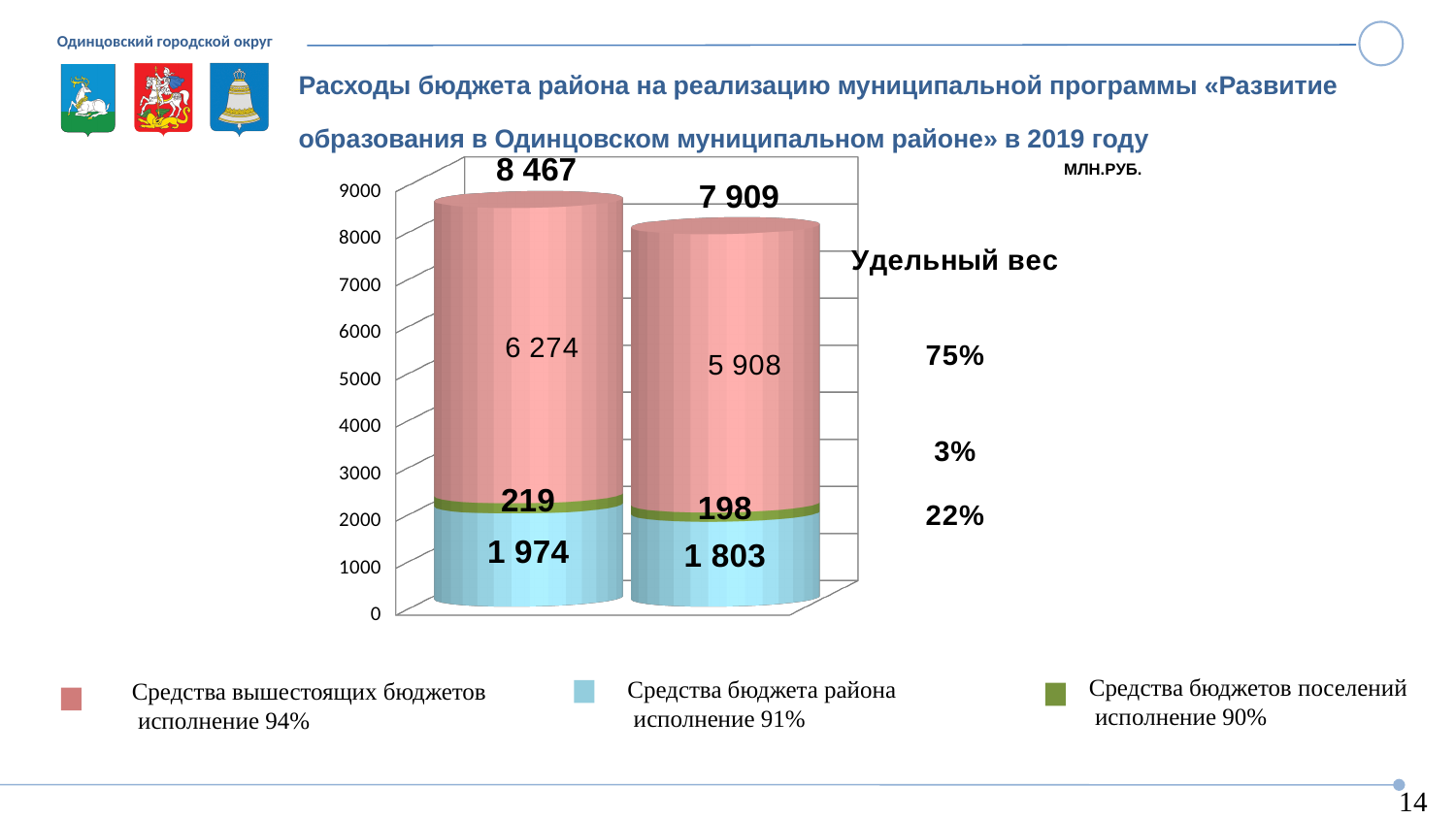
What kind of chart is shown on the slide? bar chart How many bars are plotted in the chart? 2 What is the value of the 'Средства бюджетов поселений' segment in the right bar? 198 What is the total value printed above the right bar? 7 909 What is the value of the 'Средства вышестоящих бюджетов' segment in the left bar? 6 274 What is the difference between the 'Средства бюджета района' values of the left bar (1 974) and the right bar (1 803)? 171 Which bar has the larger total, the left or the right? left How many series does the legend list? 3 What is the difference between the totals of the left bar (8 467) and the right bar (7 909)? 558 What is the value of the 'Средства бюджета района' segment in the right bar? 1 803 What is the total value printed above the left bar? 8 467 What colour represents 'Средства бюджета района' in the legend? light blue